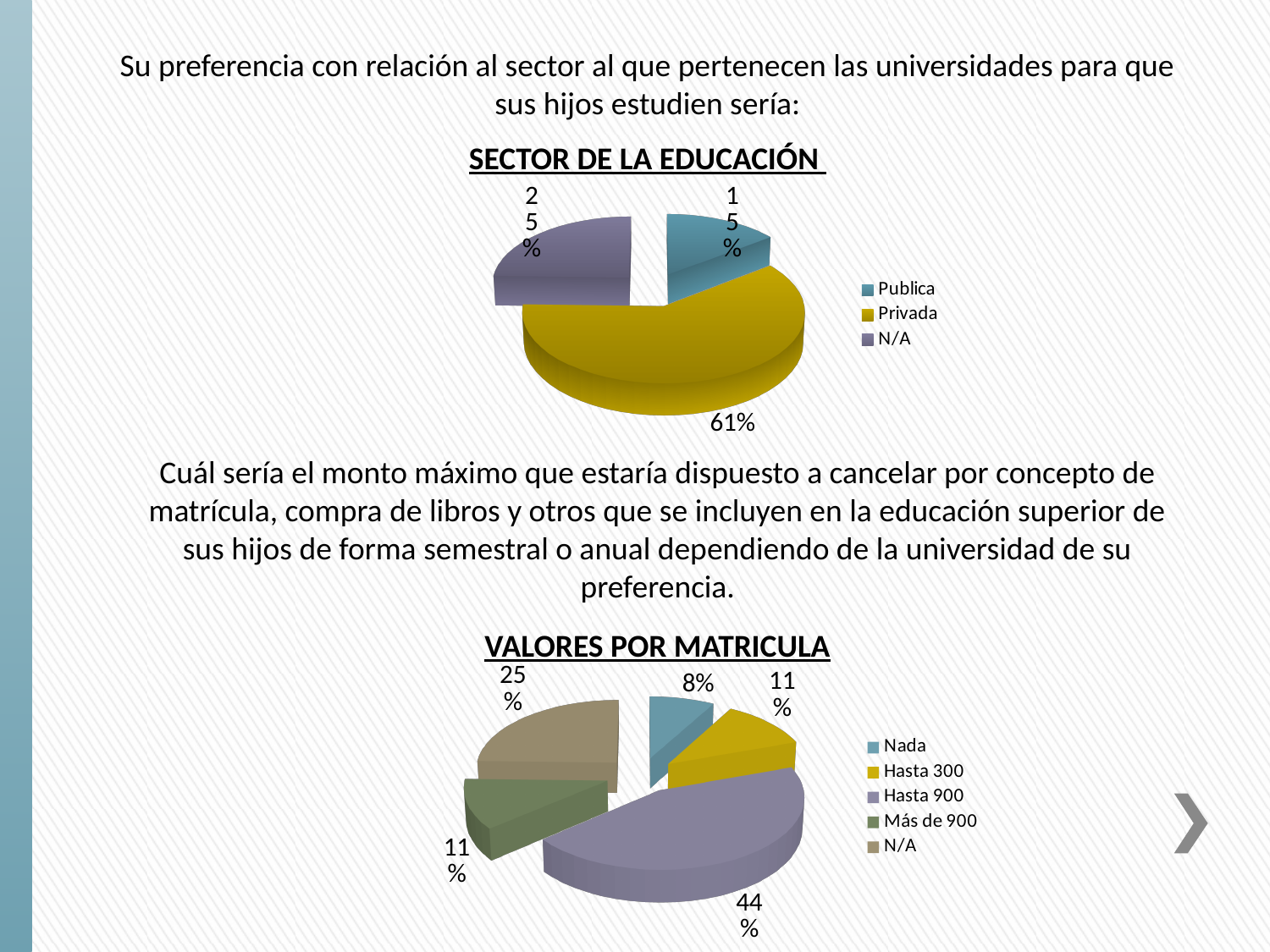
In the SECTOR DE LA EDUCACIÓN chart, how many categories does the legend list? 3 In the VALORES POR MATRICULA chart, which category has the largest share? Hasta 900 In the SECTOR DE LA EDUCACIÓN chart, which category has the largest share? Privada In the SECTOR DE LA EDUCACIÓN chart, what percentage is shown for Privada? 61% In the VALORES POR MATRICULA chart, how many categories does the legend list? 5 In the VALORES POR MATRICULA chart, what is the difference in percentage points between Hasta 900 and N/A? 19 In the VALORES POR MATRICULA chart, what percentage is shown for Hasta 900? 44% In the VALORES POR MATRICULA chart, what percentage is shown for Nada? 8% What kind of chart is the SECTOR DE LA EDUCACIÓN chart? Pie chart In the SECTOR DE LA EDUCACIÓN chart, which category has the smallest share? Publica In the SECTOR DE LA EDUCACIÓN chart, what percentage is shown for Publica? 15% In the VALORES POR MATRICULA chart, which category has the smallest share? Nada